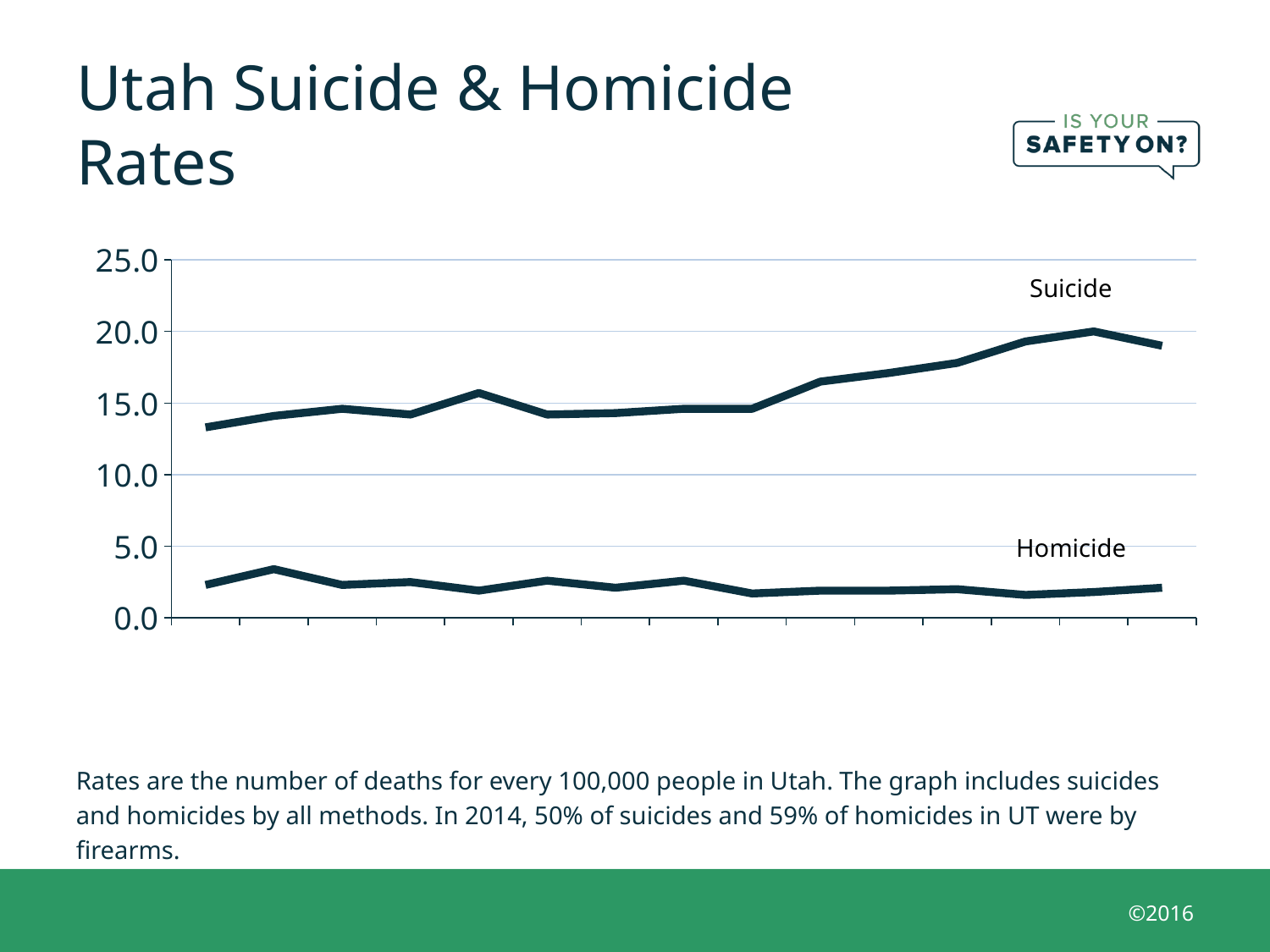
What kind of chart is shown on the slide? line chart Is the Homicide rate at the rightmost point of the chart greater or less than 5.0? less Which series has the higher values throughout the chart, Suicide or Homicide? Suicide Is the Suicide rate at the leftmost point of the chart greater or less than 10.0? greater What is the highest value shown on the chart's vertical axis? 25.0 How many data series are plotted on the chart? 2 Is the Suicide rate at the rightmost point of the chart greater or less than 15.0? greater What is the title of the slide's chart? Utah Suicide & Homicide Rates Which series is lower at every point on the chart? Homicide Does the Suicide line overall rise or fall from left to right across the chart? rise